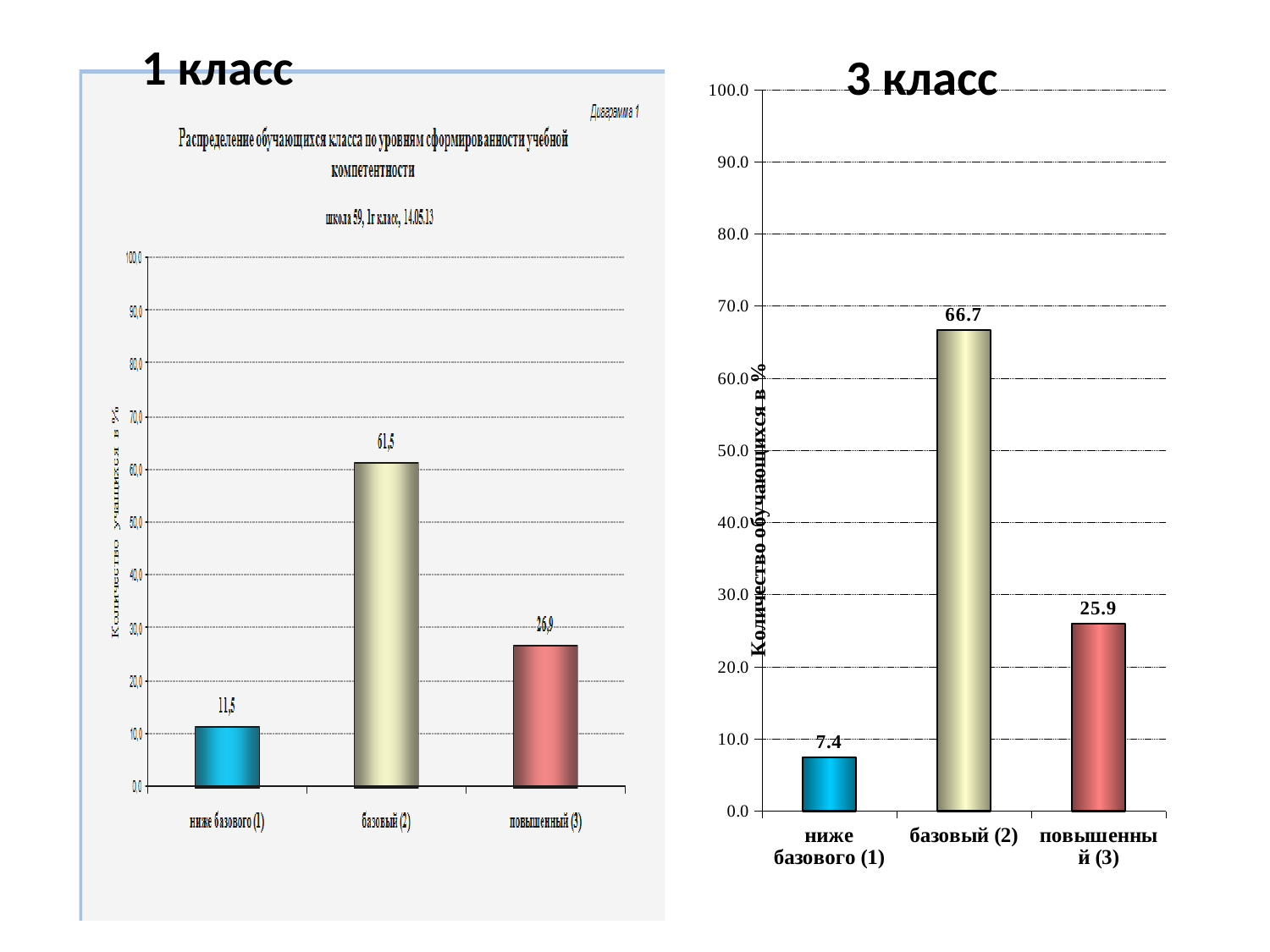
In the 3 класс chart, what is the value for ниже базового (1)? 7.4 In the 3 класс chart, what is the value for повышенный (3)? 25.9 In the 3 класс chart, what is the value for базовый (2)? 66.7 In the 3 класс chart, what is the difference between the values for базовый (2) and повышенный (3)? 40.8 In the 1 класс chart, which category has the lowest value? ниже базового (1) In the 1 класс chart, what is the value for базовый (2)? 61,5 In the 3 класс chart, which category has the highest value? базовый (2) In the 1 класс chart, what is the value for ниже базового (1)? 11,5 How many categories are shown in the 3 класс chart? 3 In the 1 класс chart, which is larger: the value for повышенный (3) or the value for ниже базового (1)? повышенный (3) In the 3 класс chart, is the value for повышенный (3) greater or less than 30.0? less What kind of chart is the 3 класс chart? bar chart